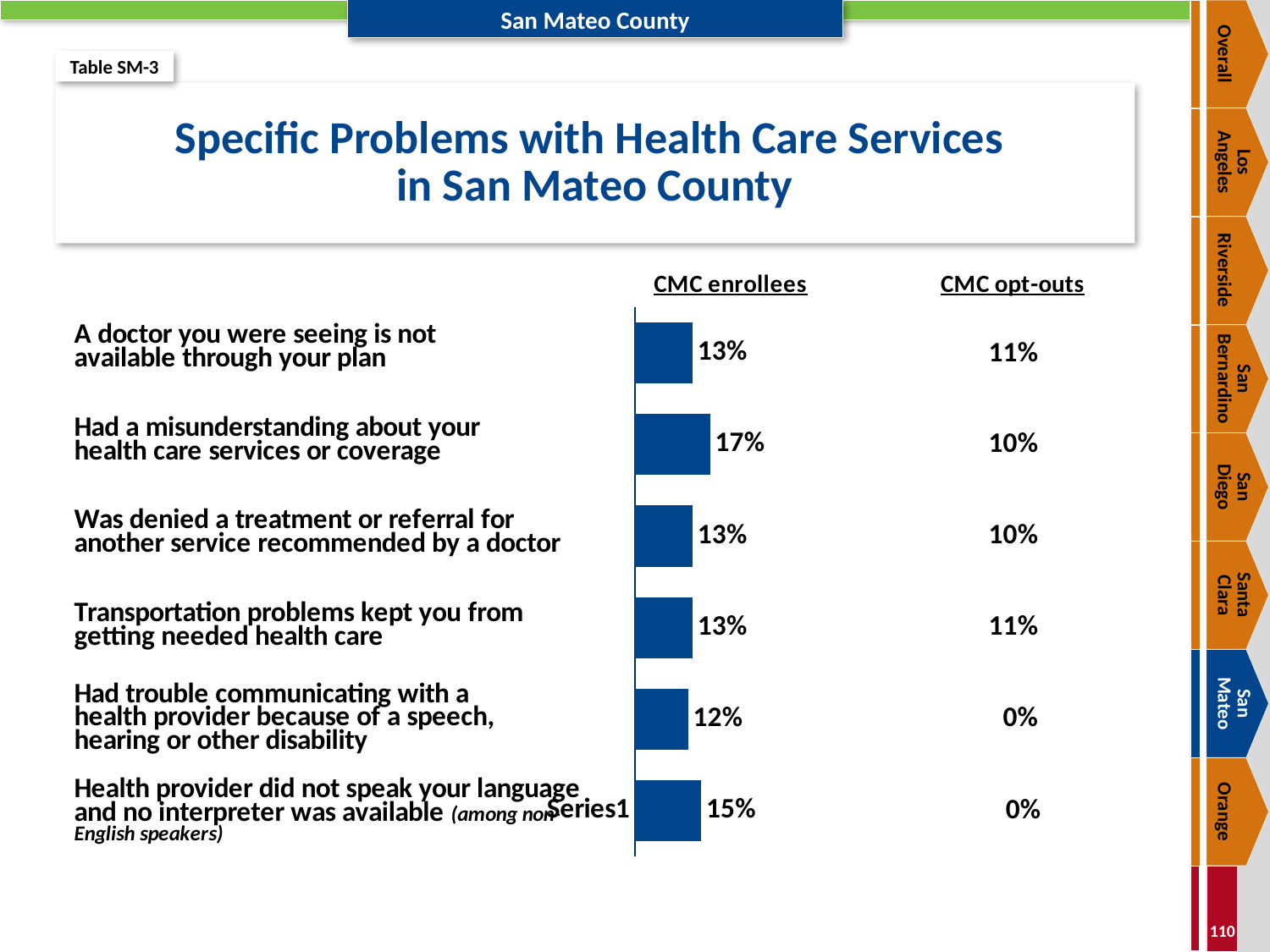
What is the CMC enrollees value for 'Health provider did not speak your language and no interpreter was available'? 15% How many problem categories are plotted as bars in the chart? 6 Which problem has the highest CMC enrollees value? Had a misunderstanding about your health care services or coverage What is the CMC opt-outs value for 'A doctor you were seeing is not available through your plan'? 11% What is the title of the chart? Specific Problems with Health Care Services in San Mateo County Which has a larger CMC enrollees value: 'Health provider did not speak your language and no interpreter was available' or 'A doctor you were seeing is not available through your plan'? Health provider did not speak your language and no interpreter was available What kind of chart is shown on the slide? bar chart Which problem has the lowest CMC enrollees value? Had trouble communicating with a health provider because of a speech, hearing or other disability What is the difference between the CMC enrollees values for 'Had a misunderstanding about your health care services or coverage' and 'Was denied a treatment or referral for another service recommended by a doctor'? 4% What is the CMC enrollees value for 'Had trouble communicating with a health provider because of a speech, hearing or other disability'? 12% What is the CMC enrollees value for 'Had a misunderstanding about your health care services or coverage'? 17% What is the CMC enrollees value for 'Transportation problems kept you from getting needed health care'? 13%